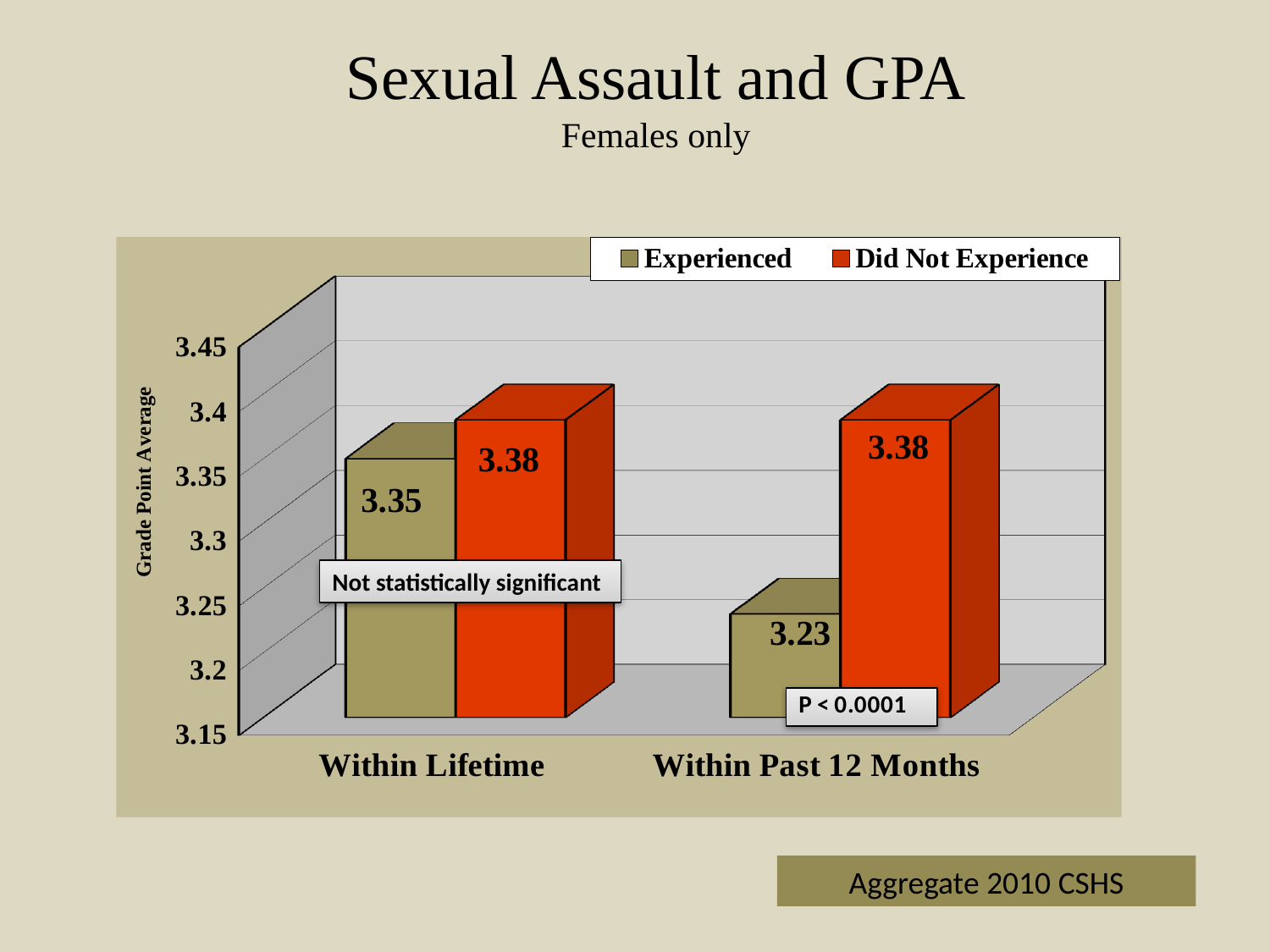
Which bar has the lowest value on the chart? Experienced, Within Past 12 Months What is the GPA for the Did Not Experience series in the Within Lifetime category? 3.38 What kind of chart is shown on the slide? Bar chart What is the GPA for the Did Not Experience series in the Within Past 12 Months category? 3.38 What is the difference between the Did Not Experience and Experienced values in the Within Past 12 Months category? 0.15 What is the label of the vertical axis? Grade Point Average What is the GPA for the Experienced series in the Within Past 12 Months category? 3.23 What is the GPA for the Experienced series in the Within Lifetime category? 3.35 How many series does the legend list? 2 What is the difference between the Did Not Experience and Experienced values in the Within Lifetime category? 0.03 How many categories are shown on the x axis? 2 In the Within Lifetime category, which series has the larger value, Experienced or Did Not Experience? Did Not Experience